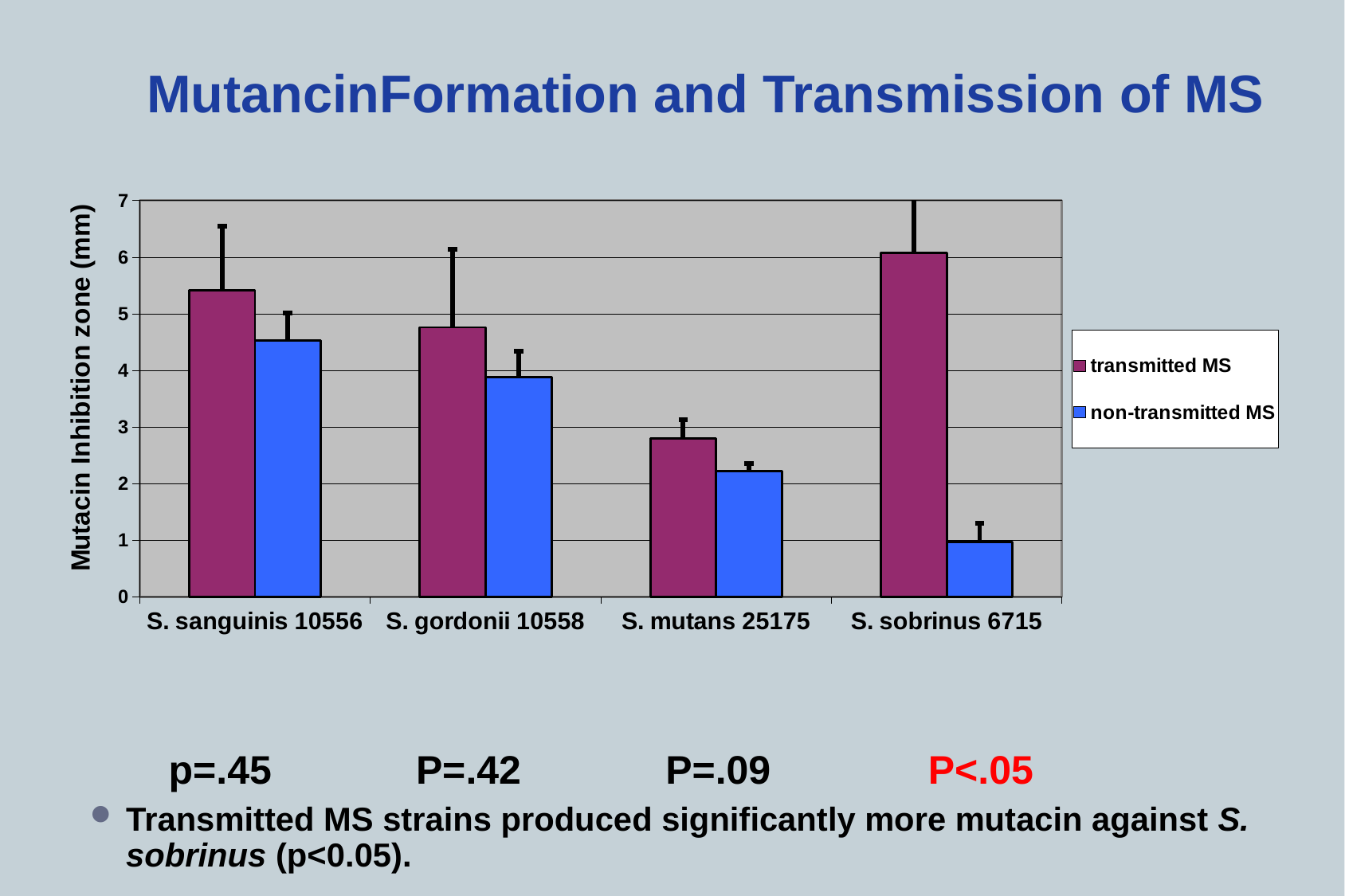
How many series does the legend list? 2 Which category has the lowest value for non-transmitted MS? S. sobrinus 6715 Is the transmitted MS value for S. sobrinus 6715 greater or less than 5? greater Is the transmitted MS value for S. sanguinis 10556 greater or less than 5? greater Is the non-transmitted MS value for S. sobrinus 6715 greater or less than 2? less Which category has the lowest value for transmitted MS? S. mutans 25175 What kind of chart is shown on the slide? bar chart How many bacterial strains (categories) are shown on the x axis? 4 Which category has the highest value for transmitted MS? S. sobrinus 6715 Which is larger: the transmitted MS value for S. sanguinis 10556 or for S. gordonii 10558? S. sanguinis 10556 What is the label of the y axis? Mutacin Inhibition zone (mm)